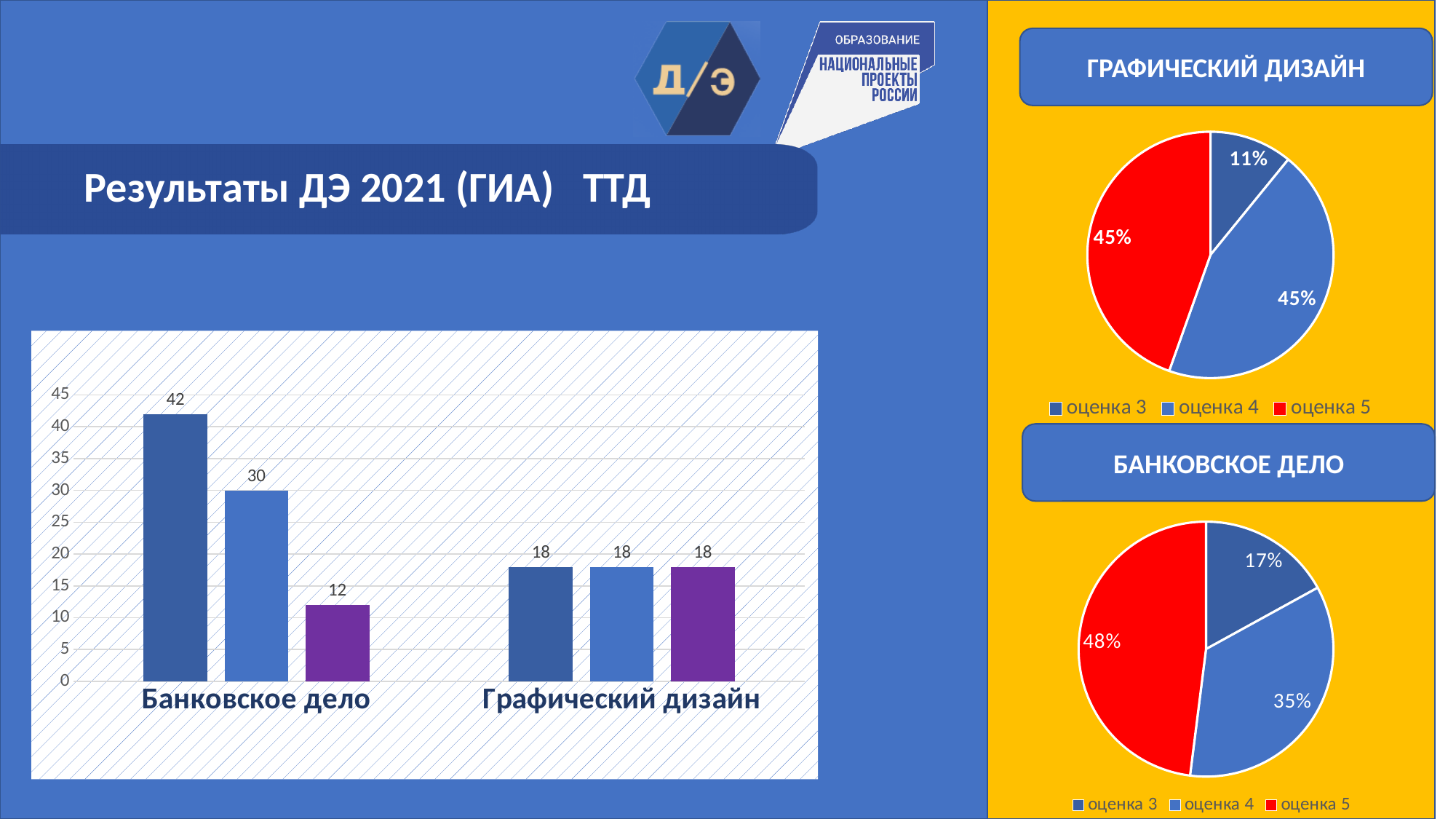
In the bar chart on the left of the slide, which category has the highest single bar? Банковское дело How many entries does the legend of the pie chart titled БАНКОВСКОЕ ДЕЛО list? 3 In the bar chart on the left of the slide, how many bars are plotted in total? 6 What kind of chart is shown on the left of the slide? bar chart In the bar chart on the left of the slide, what value do all three bars for Графический дизайн show? 18 In the pie chart titled БАНКОВСКОЕ ДЕЛО, what is the difference between the shares of оценка 5 and оценка 4? 13% In the pie chart titled БАНКОВСКОЕ ДЕЛО, which slice is the largest? оценка 5 In the pie chart titled ГРАФИЧЕСКИЙ ДИЗАЙН, what share does оценка 5 have? 45% In the bar chart on the left of the slide, what is the difference between the first (dark blue) bar and the second (light blue) bar for Банковское дело? 12 In the pie chart titled ГРАФИЧЕСКИЙ ДИЗАЙН, what share does оценка 3 have? 11% In the bar chart on the left of the slide, what is the value of the tallest bar for Банковское дело? 42 In the bar chart on the left of the slide, what is the value of the purple bar for Банковское дело? 12